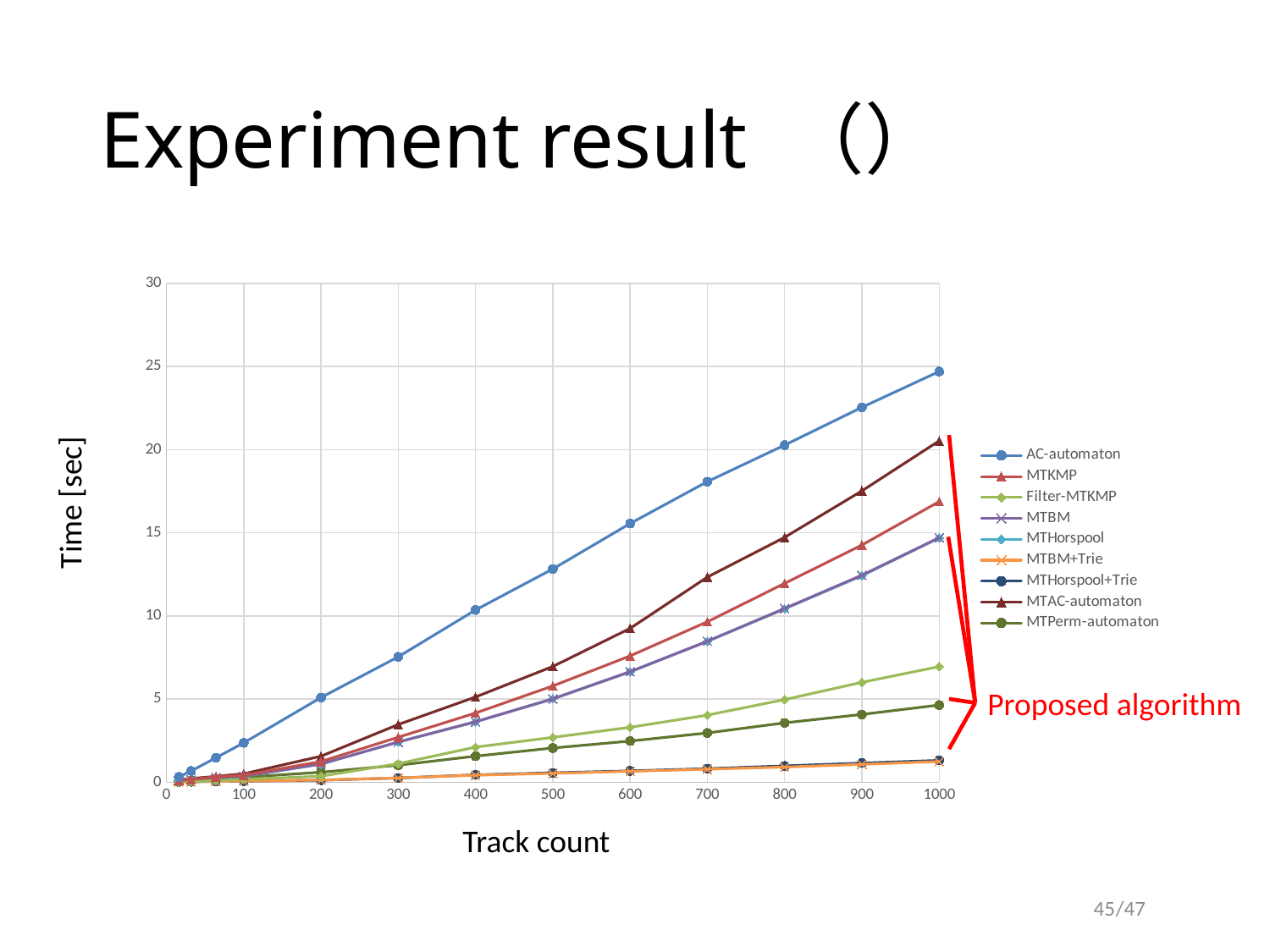
What kind of chart is shown on the slide? line chart Is the value for AC-automaton at a track count of 500 greater or less than 10? greater What is the label of the x axis? Track count Is the value for AC-automaton at a track count of 1000 greater or less than 20? greater Which series has the highest time at a track count of 1000? AC-automaton How many series does the legend list? 9 At a track count of 1000, which is larger: MTAC-automaton or MTKMP? MTAC-automaton Does the time for AC-automaton rise or fall as the track count increases? rise Is the value for Filter-MTKMP at a track count of 1000 greater or less than 5? greater At a track count of 1000, which is larger: Filter-MTKMP or MTPerm-automaton? Filter-MTKMP